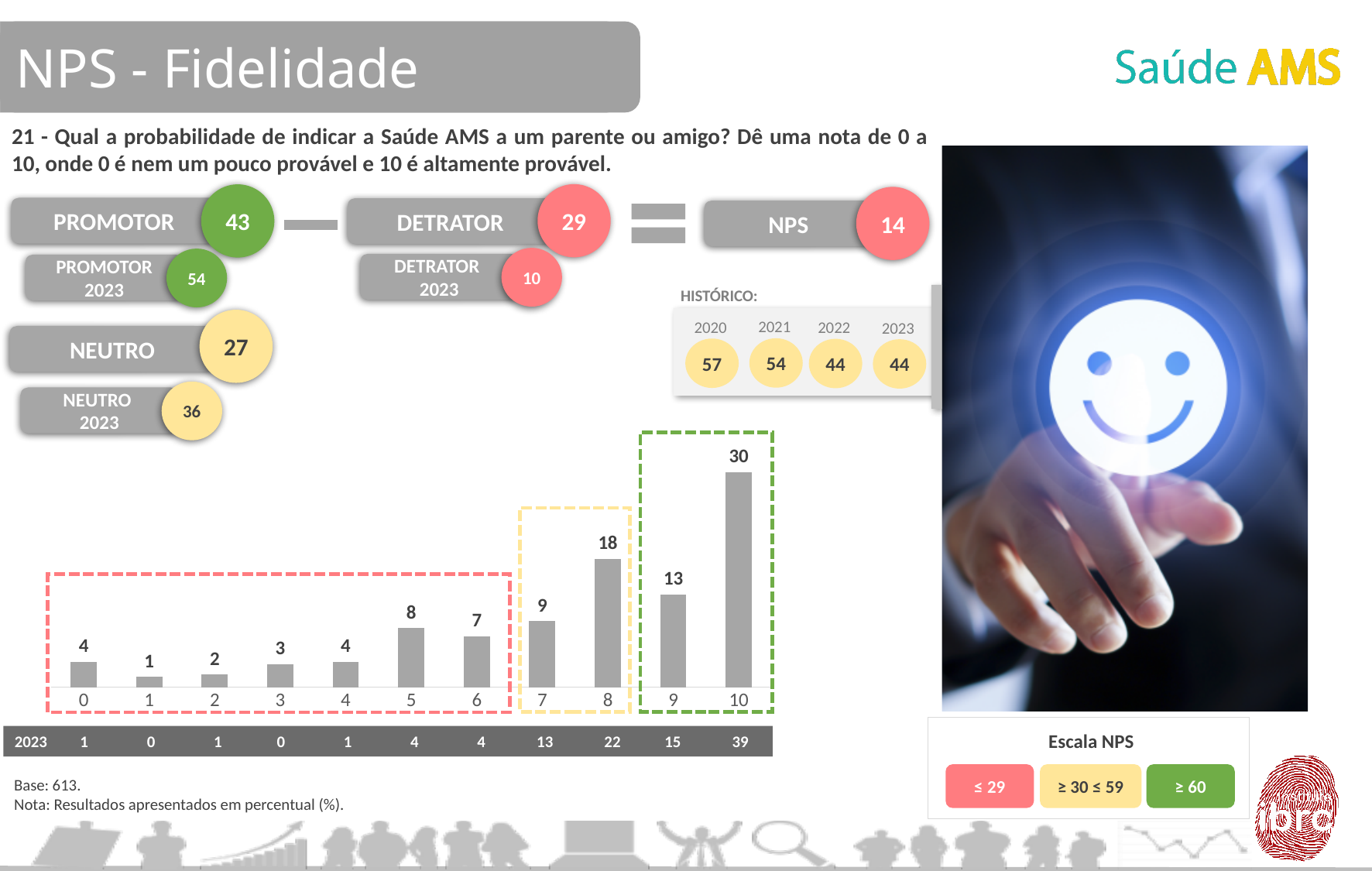
What kind of chart is used to show the distribution of scores from 0 to 10? bar chart In the 2023 row below the chart, what is the value for score 10? 39 What is the value of the bar for score 5? 8 What is the value of the bar for score 8? 18 What is the value of the bar for score 10? 30 Which score has the highest bar in the chart? 10 What is the total of the bars for scores 9 and 10 (the green dashed group)? 43 How many score categories are shown on the x axis of the bar chart? 11 Which score has the lowest bar in the chart? 1 What is the difference between the bar for score 8 and the bar for score 7? 9 Which bar is taller, score 6 or score 7? 7 What is the difference between the bars for score 10 and score 9? 17